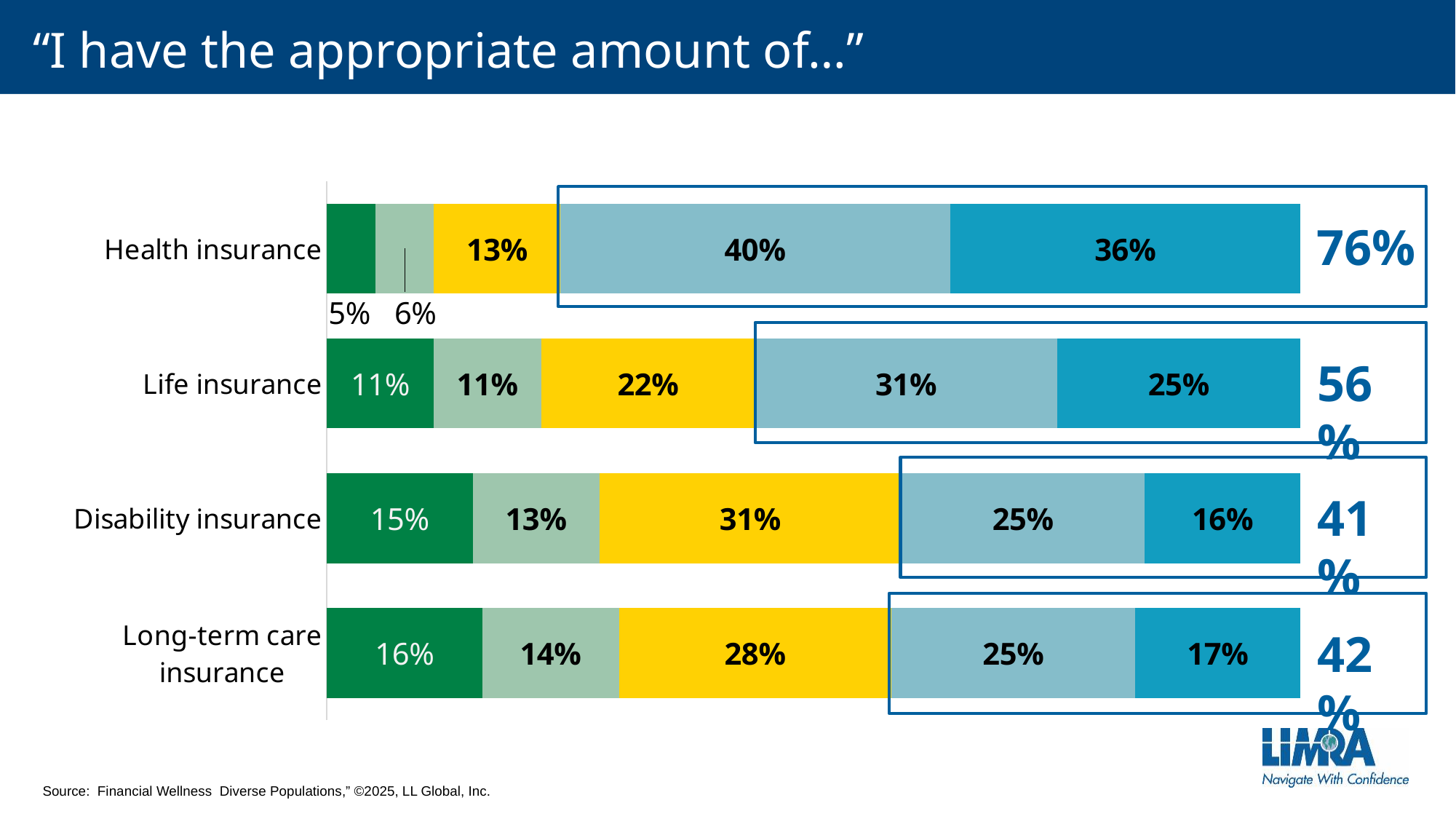
What is the value of the rightmost (dark blue) segment of the Health insurance bar? 36% Which has the larger yellow segment, Disability insurance or Long-term care insurance? Disability insurance What is the boxed total shown to the right of the Life insurance bar? 56% How many insurance categories are plotted in the chart? 4 What is the title of the slide? "I have the appropriate amount of..." What kind of chart is shown on the slide? Stacked bar chart Which category has the lowest boxed total at the right of its bar? Disability insurance What is the value of the yellow segment in the Health insurance bar? 13% What is the difference between the boxed totals for Health insurance (76%) and Life insurance (56%)? 20 percentage points What is the value of the leftmost (dark green) segment of the Long-term care insurance bar? 16% What is the combined value of the two blue segments (25% and 16%) in the Disability insurance bar? 41% Which category has the highest boxed total at the right of its bar? Health insurance